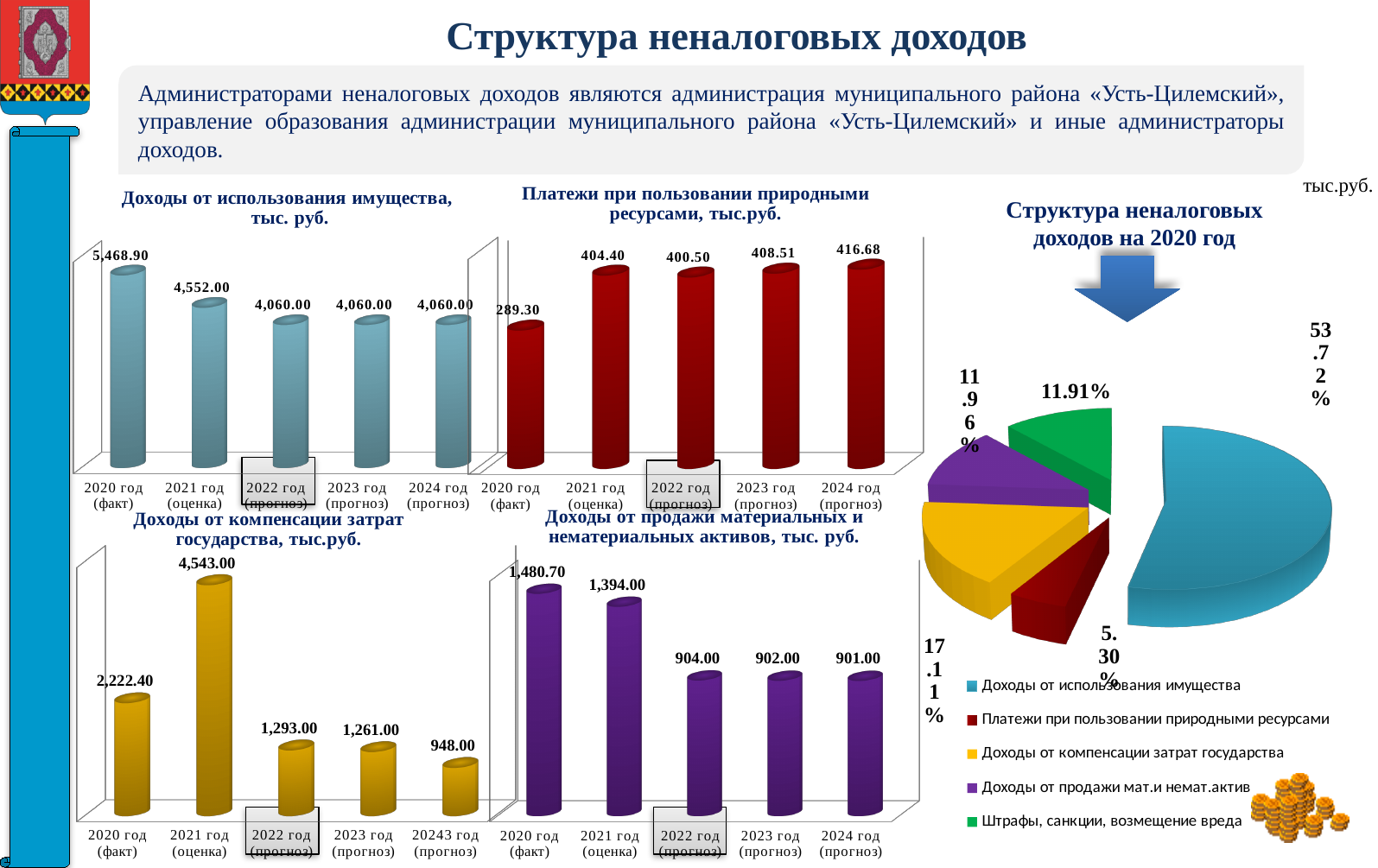
In the chart 'Доходы от продажи материальных и нематериальных активов, тыс. руб.', do the values rise or fall from 2020 to 2024? fall In the chart 'Платежи при пользовании природными ресурсами, тыс.руб.', which year has the lowest value? 2020 год (факт) In the chart 'Доходы от продажи материальных и нематериальных активов, тыс. руб.', which is larger: the value for 2020 год (факт) or 2021 год (оценка)? 2020 год (факт) In the chart 'Доходы от использования имущества, тыс. руб.', which year has the highest value? 2020 год (факт) In the chart 'Доходы от использования имущества, тыс. руб.', what is the value for 2020 год (факт)? 5,468.90 How many entries does the legend of the pie chart 'Структура неналоговых доходов на 2020 год' list? 5 In the pie chart 'Структура неналоговых доходов на 2020 год', which category has the smallest share? Платежи при пользовании природными ресурсами How many bars are in the chart 'Доходы от продажи материальных и нематериальных активов, тыс. руб.'? 5 In the chart 'Доходы от компенсации затрат государства, тыс.руб.', what is the value for 2024 год (прогноз)? 948.00 In the chart 'Доходы от компенсации затрат государства, тыс.руб.', what is the difference between the 2021 год (оценка) value and the 2020 год (факт) value? 2,320.60 In the chart 'Платежи при пользовании природными ресурсами, тыс.руб.', what is the value for 2024 год (прогноз)? 416.68 In the pie chart 'Структура неналоговых доходов на 2020 год', what share does 'Доходы от использования имущества' have? 53.72%